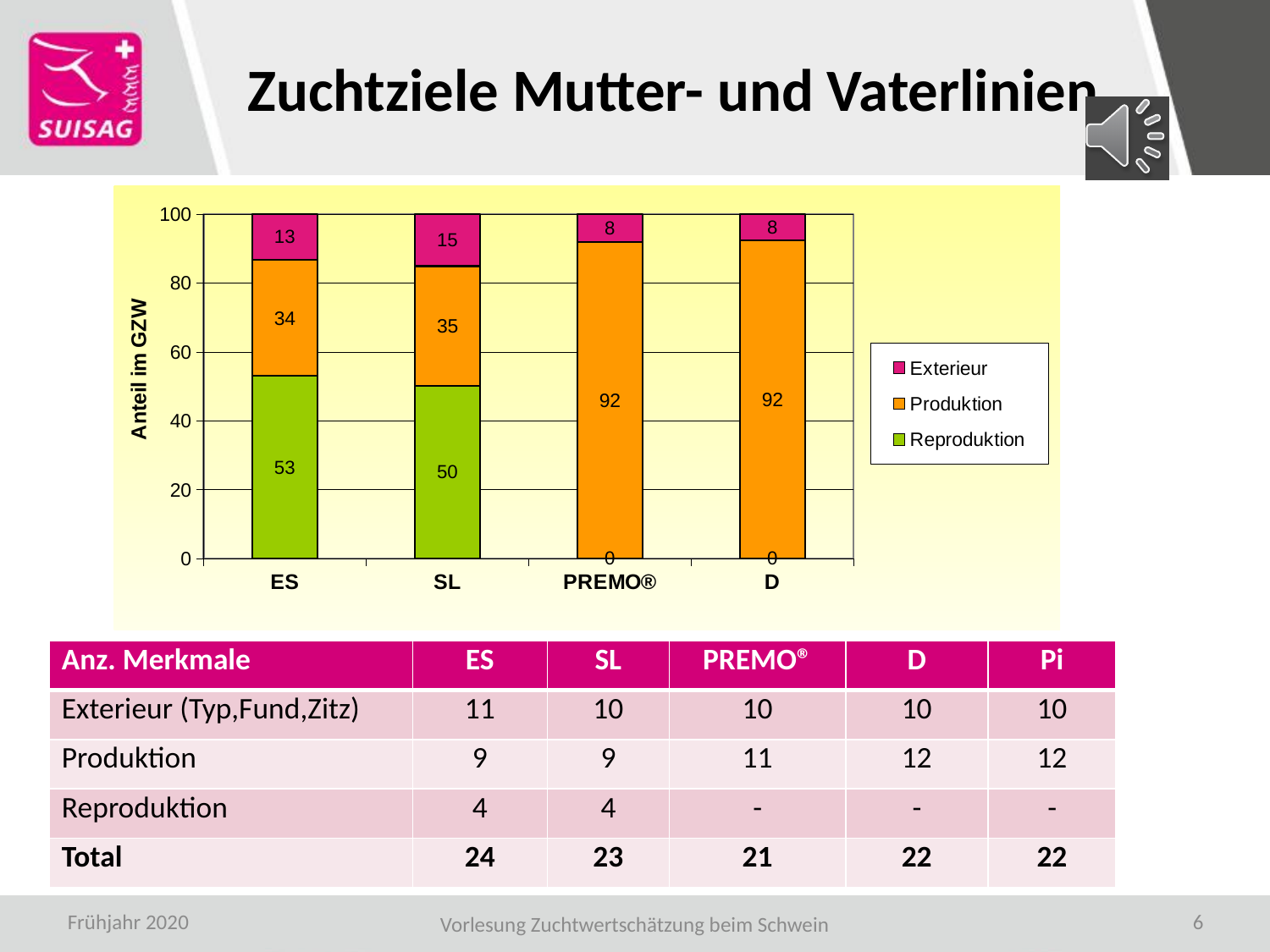
What is the Produktion value for PREMO® in the chart? 92 How many series does the chart legend list? 3 How many categories are shown on the x axis of the chart? 4 What kind of chart is shown on the slide? Stacked bar chart What is the difference between the Reproduktion values for ES and SL in the chart? 3 Which category has the highest Produktion value in the chart? PREMO® and D (both 92) What is the Exterieur value for SL in the chart? 15 Which is larger in the chart: the Exterieur value for ES or for SL? SL What is the label of the y axis of the chart? Anteil im GZW Which category has the lowest Exterieur value in the chart? PREMO® and D (both 8) What is the Reproduktion value for ES in the chart? 53 What is the Produktion value for SL in the chart? 35